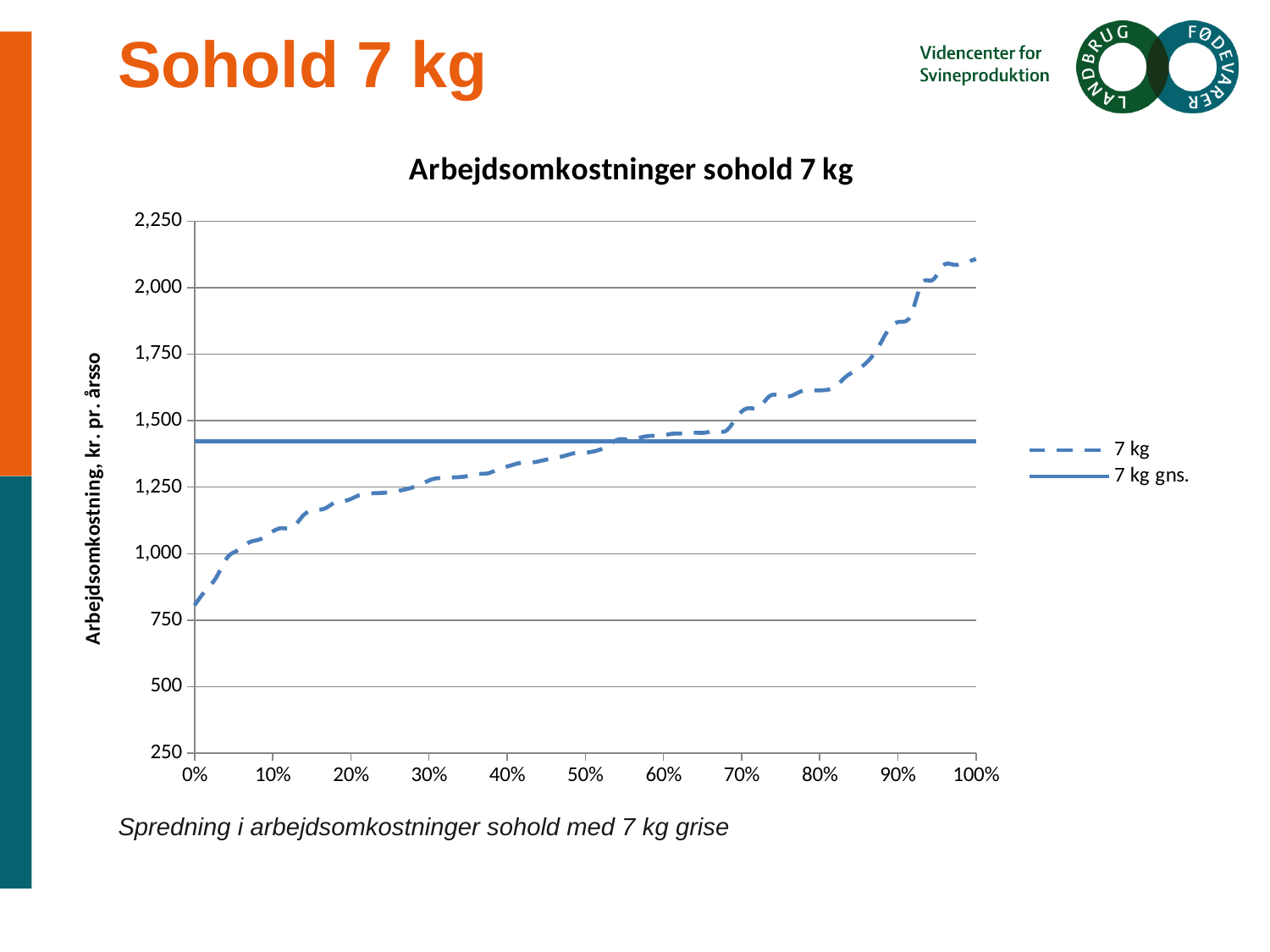
Is the value of the 7 kg gns. line greater or less than 1,250? greater Is the value of the 7 kg series at 90% greater or less than 1,750? greater At 100%, which is larger: the 7 kg series or the 7 kg gns. line? 7 kg Is the value of the 7 kg series at 0% greater or less than 1,000? less What are the two entries in the chart legend? 7 kg and 7 kg gns. Does the dashed 7 kg line rise or fall as the x axis goes from 0% to 100%? rise How many series does the legend list? 2 At 0%, which is larger: the 7 kg series or the 7 kg gns. line? 7 kg gns. What is the title of the chart? Arbejdsomkostninger sohold 7 kg What kind of chart is shown on the slide? line chart